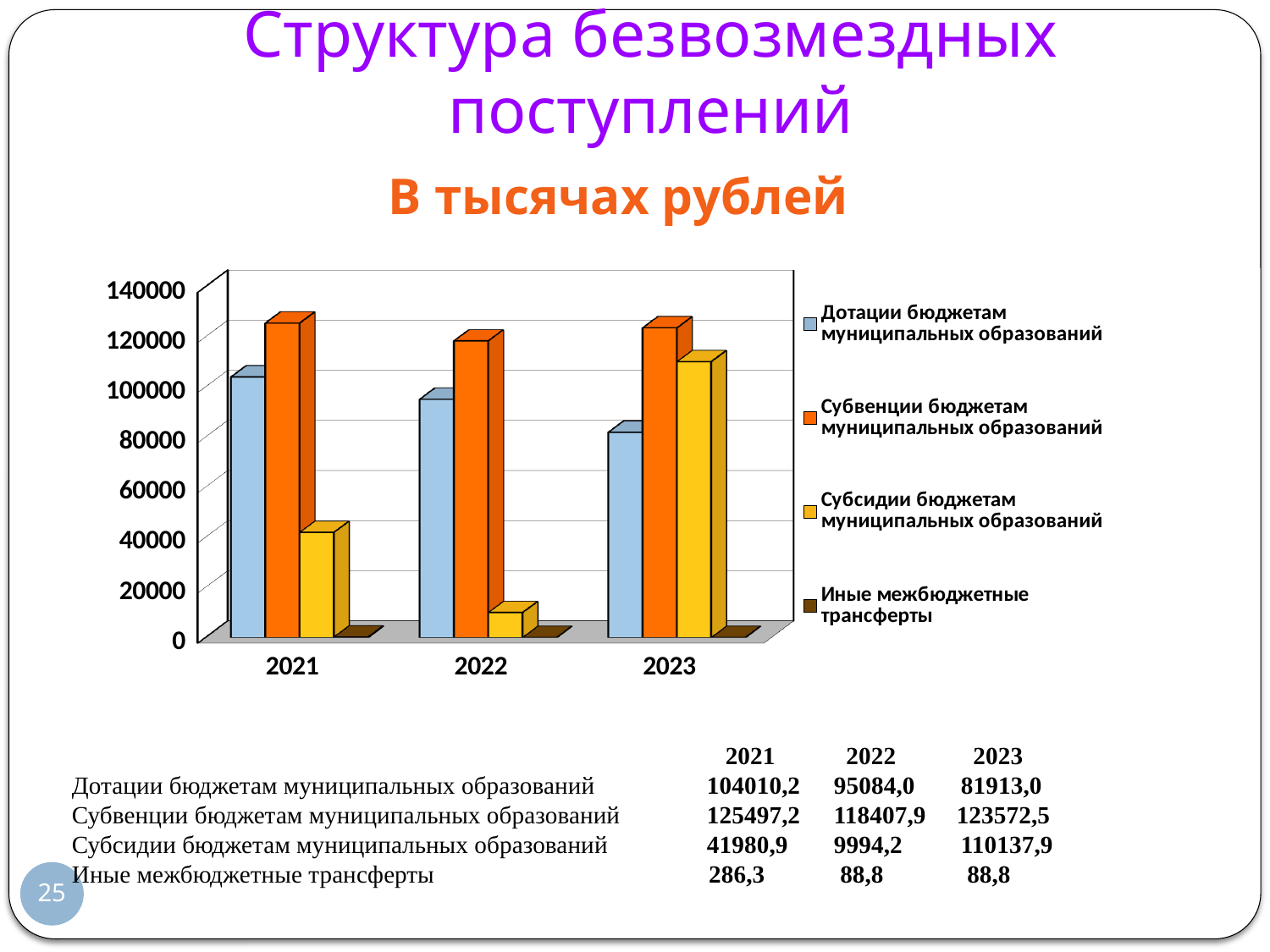
What is the value of Дотации бюджетам муниципальных образований in 2021? 104010,2 What is the difference between Субвенции бюджетам муниципальных образований in 2021 and in 2022? 7089,3 In which year is Субсидии бюджетам муниципальных образований lowest? 2022 Do the values for Дотации бюджетам муниципальных образований rise or fall from 2021 to 2023? fall What is the value of Субсидии бюджетам муниципальных образований in 2023? 110137,9 In 2023, which is larger: Субвенции бюджетам муниципальных образований or Субсидии бюджетам муниципальных образований? Субвенции бюджетам муниципальных образований What colour represents Субвенции бюджетам муниципальных образований in the chart? orange What kind of chart is shown on the slide? bar chart In which year is Субвенции бюджетам муниципальных образований highest? 2021 How many series does the legend list? 4 Is the value for Дотации бюджетам муниципальных образований in 2022 greater or less than 100000? less How many years are shown on the x axis of the chart? 3